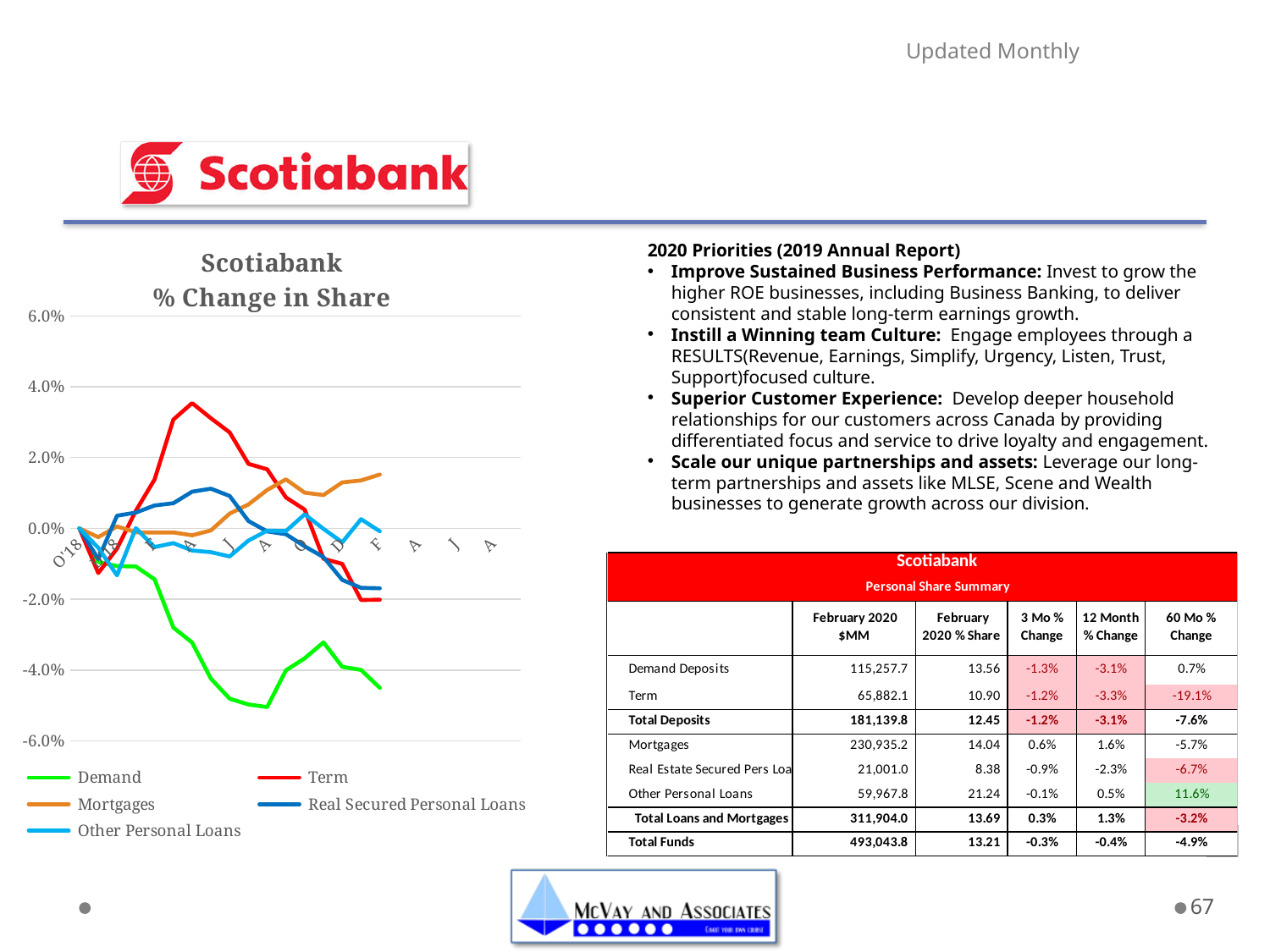
Is the lowest value of the Demand series greater or less than -4.0%? less What kind of chart is shown on the slide? Line chart Which series reaches the lowest value on the chart? Demand Is the peak value of the Mortgages series greater or less than 2.0%? less Which series in the chart is drawn in green? Demand Does the Demand series generally rise or fall across the period shown? fall How many series does the legend of the chart list? 5 Which series reaches the highest value on the chart? Term What is the title of the chart? Scotiabank % Change in Share Is the final plotted value of the Term series greater or less than 0.0%? less At the right end of the plotted lines, which is higher: Mortgages or Demand? Mortgages